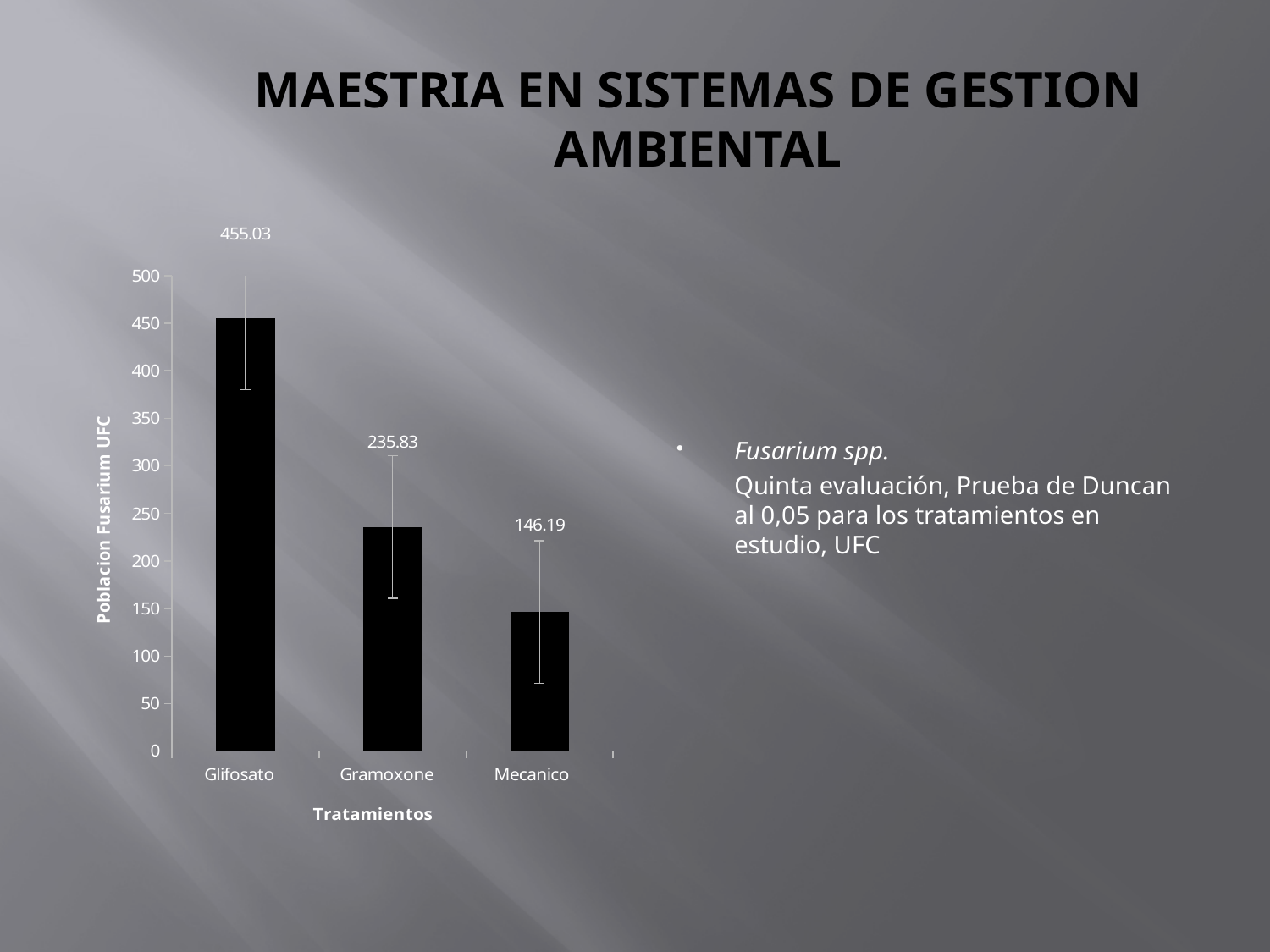
Is the value for Mecanico greater or less than 200? less Which treatment has the highest Poblacion Fusarium UFC? Glifosato What is the difference between the values for Gramoxone and Mecanico? 89.64 What is the value for Glifosato? 455.03 What kind of chart is shown on the slide? bar chart How many treatments are shown on the x axis? 3 Which treatment has the lowest Poblacion Fusarium UFC? Mecanico What is the value for Mecanico? 146.19 What is the difference between the values for Glifosato and Gramoxone? 219.2 What is the value for Gramoxone? 235.83 Which is larger, the value for Gramoxone or the value for Mecanico? Gramoxone What is the label of the x axis? Tratamientos